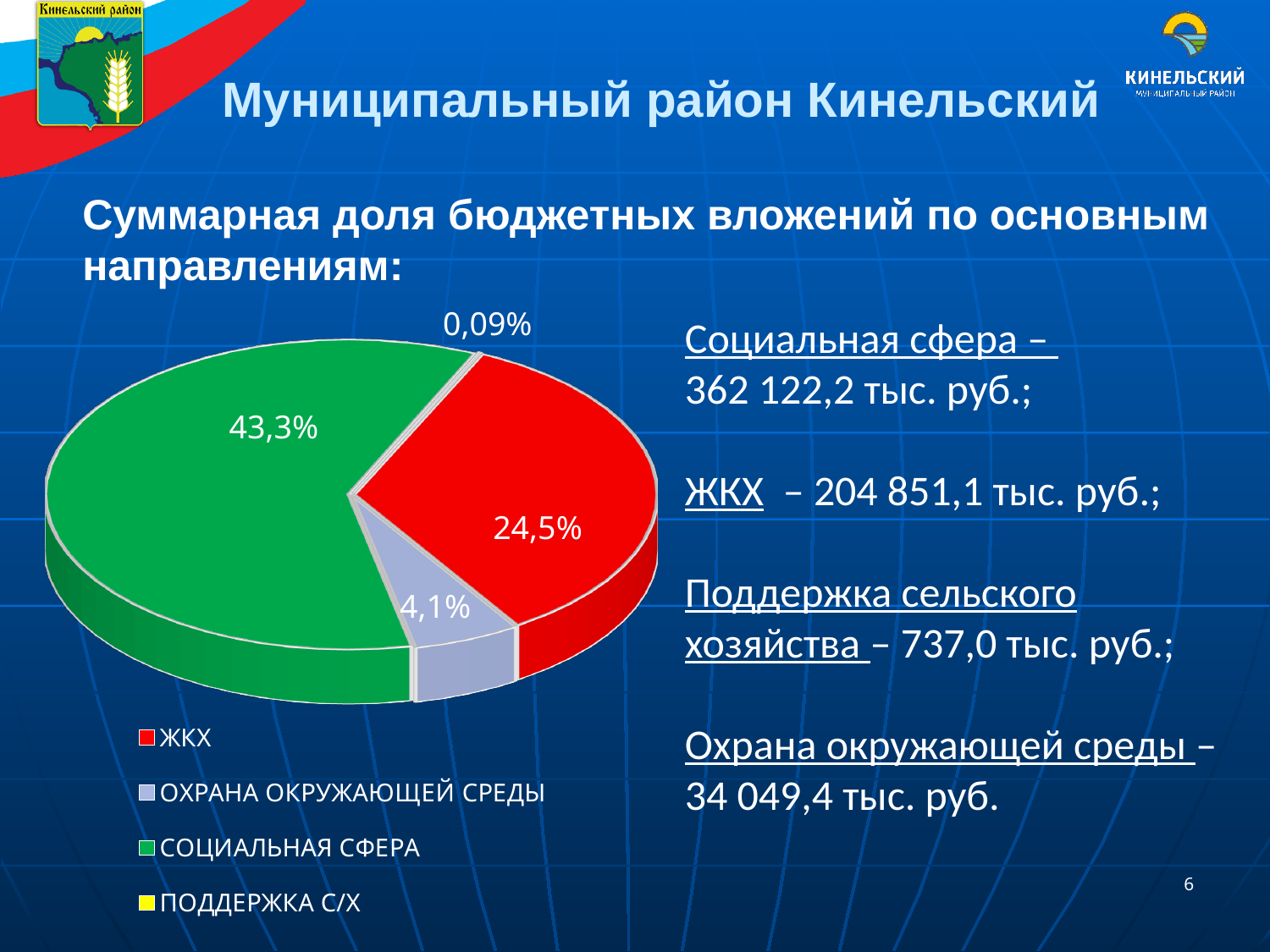
What colour is the slice for ЖКХ? Red Which is larger, the slice for ЖКХ or the slice for ОХРАНА ОКРУЖАЮЩЕЙ СРЕДЫ? ЖКХ What is the difference in percentage points between the СОЦИАЛЬНАЯ СФЕРА slice and the ЖКХ slice? 18,8 What kind of chart is shown on the slide? Pie chart What share of the pie does ПОДДЕРЖКА С/Х have? 0,09% Which category has the smallest slice of the pie? ПОДДЕРЖКА С/Х What share of the pie does СОЦИАЛЬНАЯ СФЕРА have? 43,3% What share of the pie does ЖКХ have? 24,5% What colour is the slice for СОЦИАЛЬНАЯ СФЕРА? Green What share of the pie does ОХРАНА ОКРУЖАЮЩЕЙ СРЕДЫ have? 4,1% How many categories does the legend of the pie chart list? 4 Which category has the largest slice of the pie? СОЦИАЛЬНАЯ СФЕРА